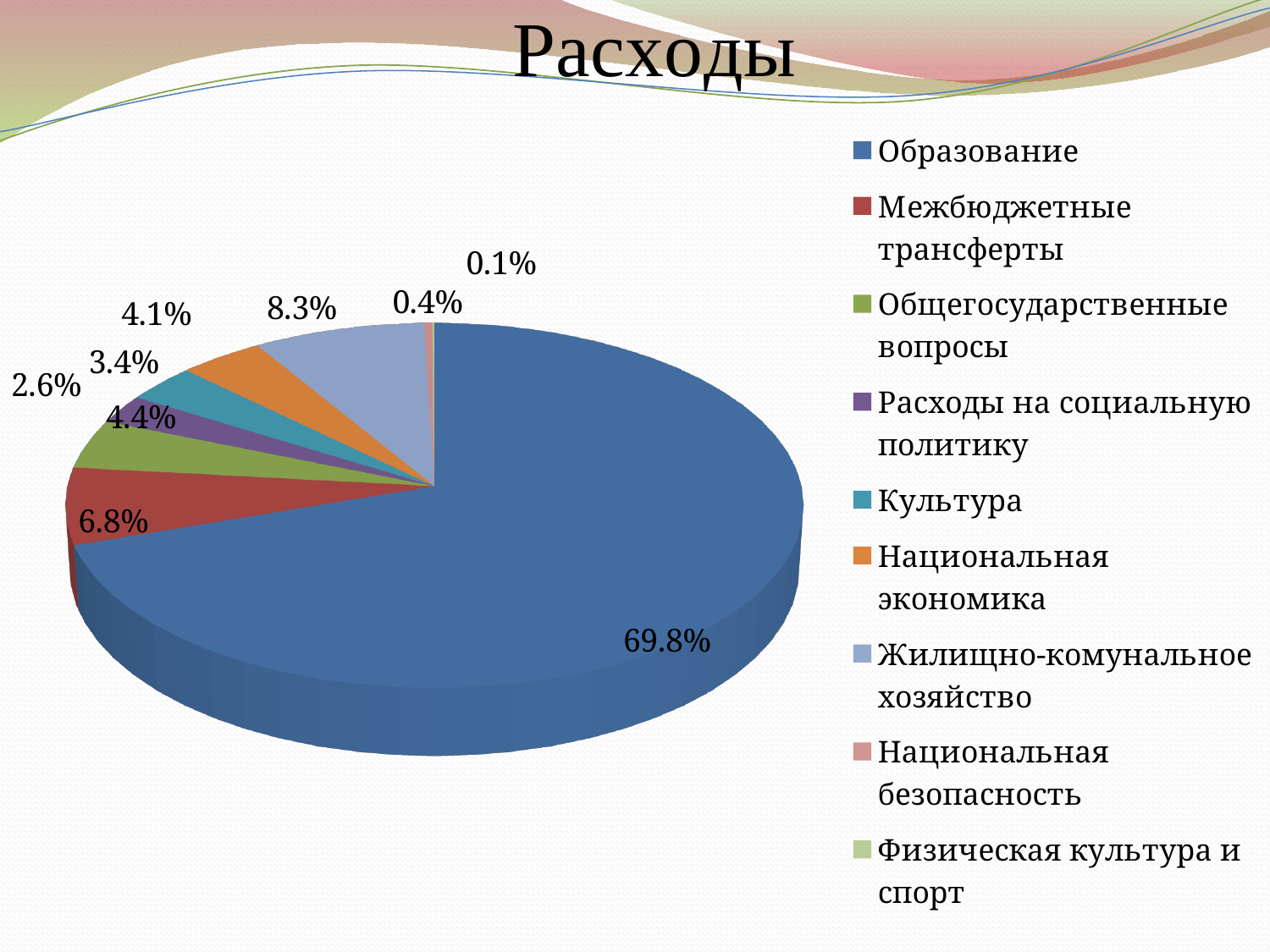
What is the title of the chart? Расходы What colour is the slice for Национальная экономика? orange What is the value for Межбюджетные трансферты? 6.8% What is the difference between the shares of Образование and Жилищно-комунальное хозяйство? 61.5% What type of chart is shown on the slide? pie chart What share of the pie does Образование take? 69.8% How many categories does the legend list? 9 What is the value for Жилищно-комунальное хозяйство? 8.3% Which category has the smallest slice? Физическая культура и спорт Which category has the largest slice? Образование Which is larger, Жилищно-комунальное хозяйство or Межбюджетные трансферты? Жилищно-комунальное хозяйство What is the value for Физическая культура и спорт? 0.1%